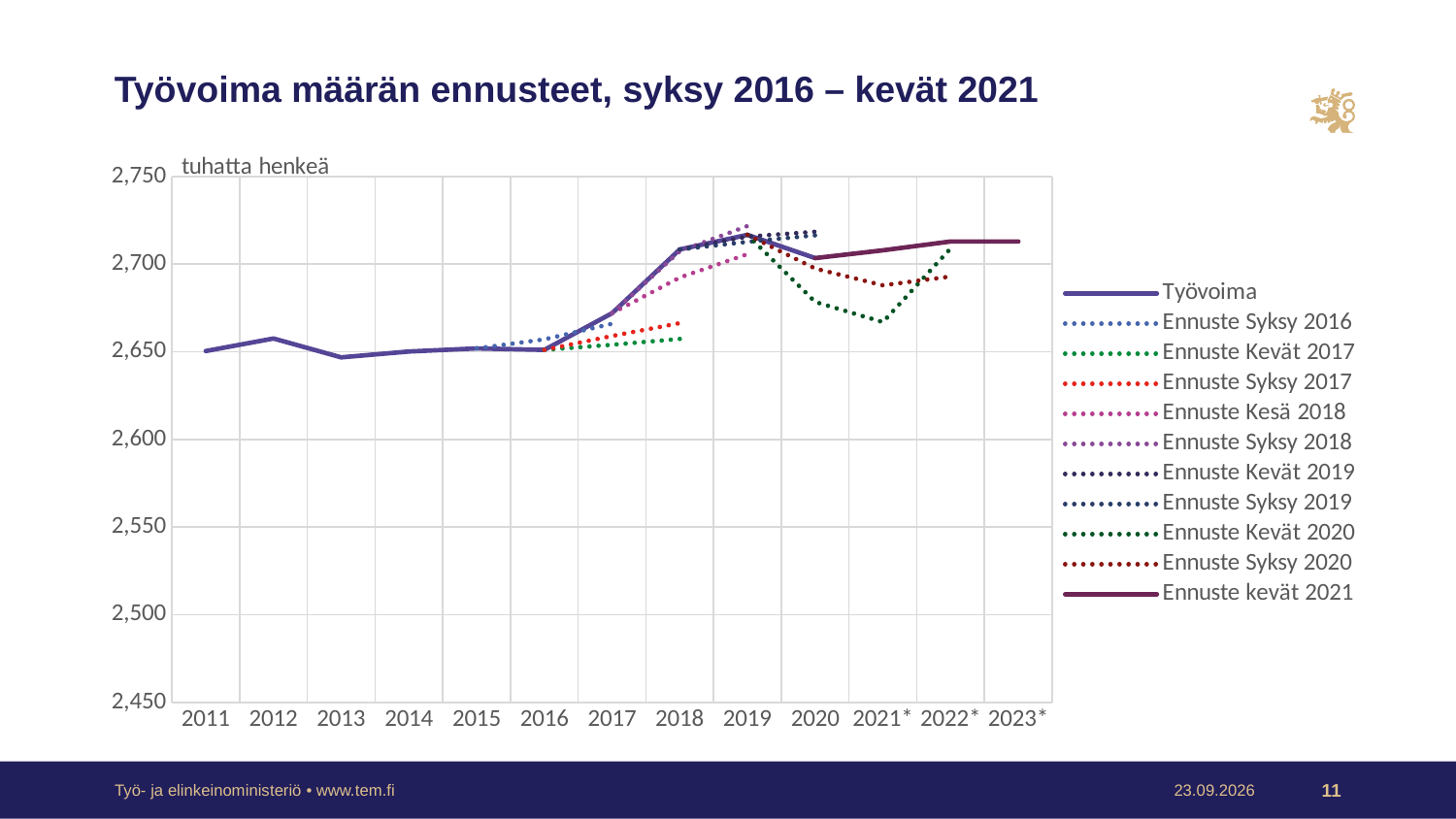
At 2021*, which is higher: Ennuste Syksy 2020 or Ennuste Kevät 2020? Ennuste Syksy 2020 How many series does the legend list? 11 Is the Ennuste kevät 2021 value for 2023* greater or less than 2,700? greater Does the Työvoima series rise or fall from 2016 to 2019? rise What is the title of the chart? Työvoima määrän ennusteet, syksy 2016 – kevät 2021 What kind of chart is shown on the slide? line chart What unit label is shown at the top of the y axis? tuhatta henkeä Which year has the highest Työvoima value? 2019 How many years are shown on the x axis? 13 Is the Ennuste Kevät 2017 value for 2018 greater or less than 2,700? less Is the Ennuste Kevät 2020 value for 2021* greater or less than 2,700? less